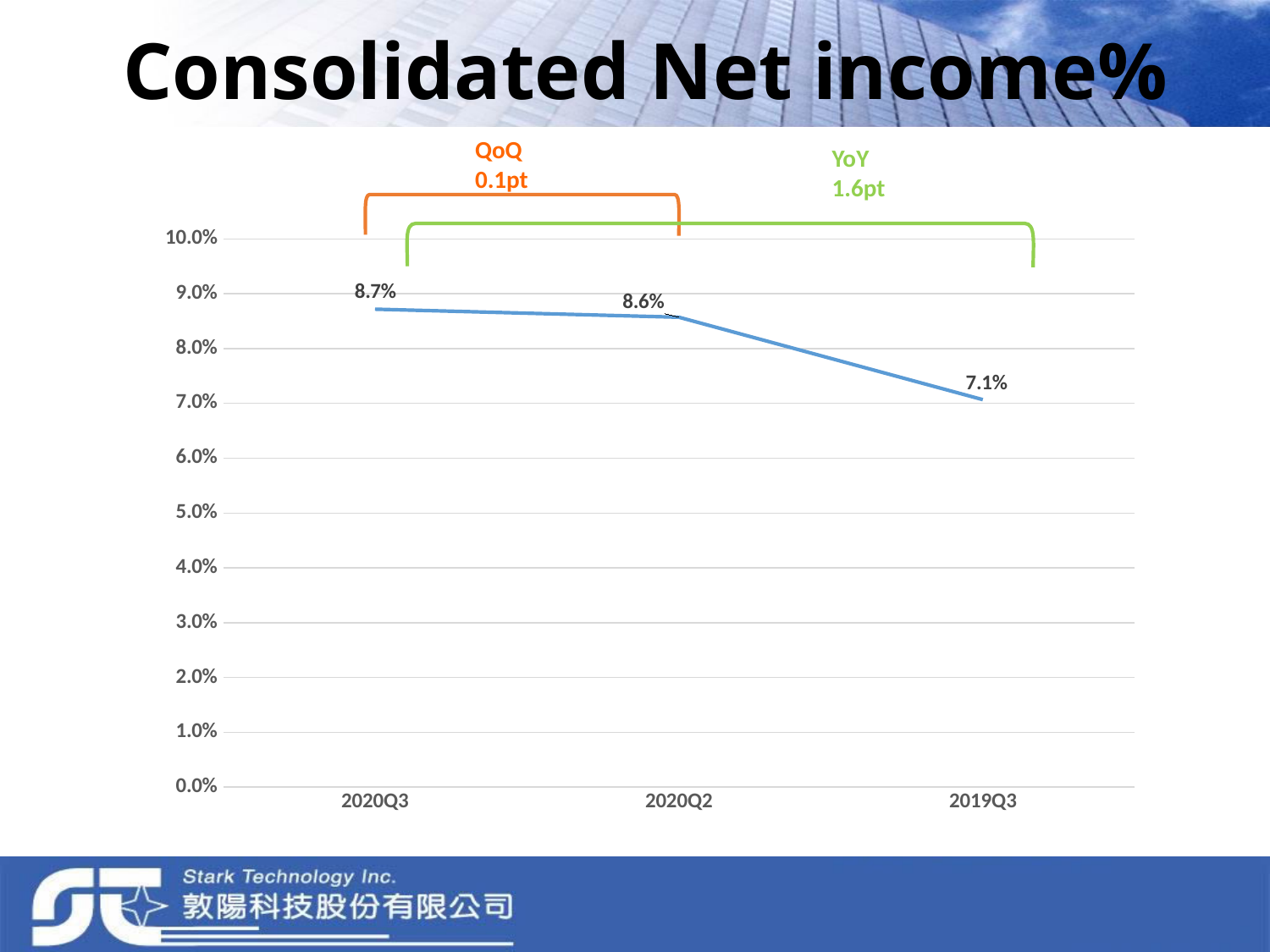
How many periods are plotted on the chart? 3 What is the consolidated net income % for 2020Q3? 8.7% Which period has the highest consolidated net income %? 2020Q3 What is the consolidated net income % for 2019Q3? 7.1% What is the difference in consolidated net income % between 2020Q3 and 2019Q3? 1.6pt Which period has the lowest consolidated net income %? 2019Q3 What is the difference in consolidated net income % between 2020Q3 and 2020Q2? 0.1pt What is the title of the chart on the slide? Consolidated Net income% What kind of chart is shown on the slide? Line chart Which is larger, the consolidated net income % for 2020Q2 or for 2019Q3? 2020Q2 What is the consolidated net income % for 2020Q2? 8.6% Is the value for 2019Q3 greater or less than 8.0%? less